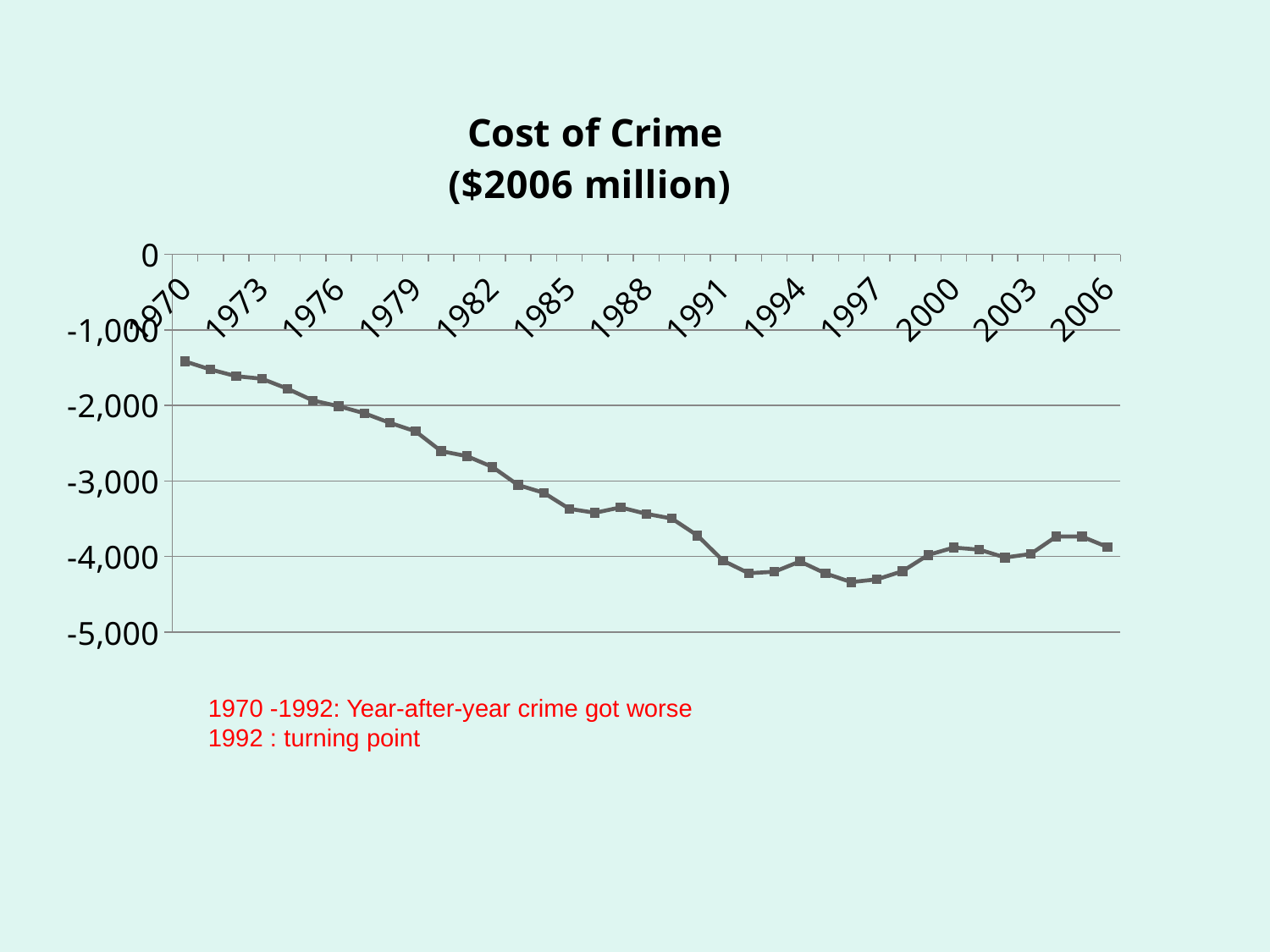
Is the value for 1979 greater or less than -2,000? less Do the values rise or fall along the x axis from 1970 to 1991? fall Is the value for 1985 greater or less than -3,000? less Which is larger, the value for 1985 or the value for 1994? 1985 Is the value for 1970 greater or less than -2,000? greater Which is larger, the value for 1970 or the value for 2006? 1970 What kind of chart is shown on the slide? line chart Which year has the highest (least negative) value on the chart? 1970 What is the title of the chart? Cost of Crime ($2006 million) What is the lowest value shown on the vertical axis? -5,000